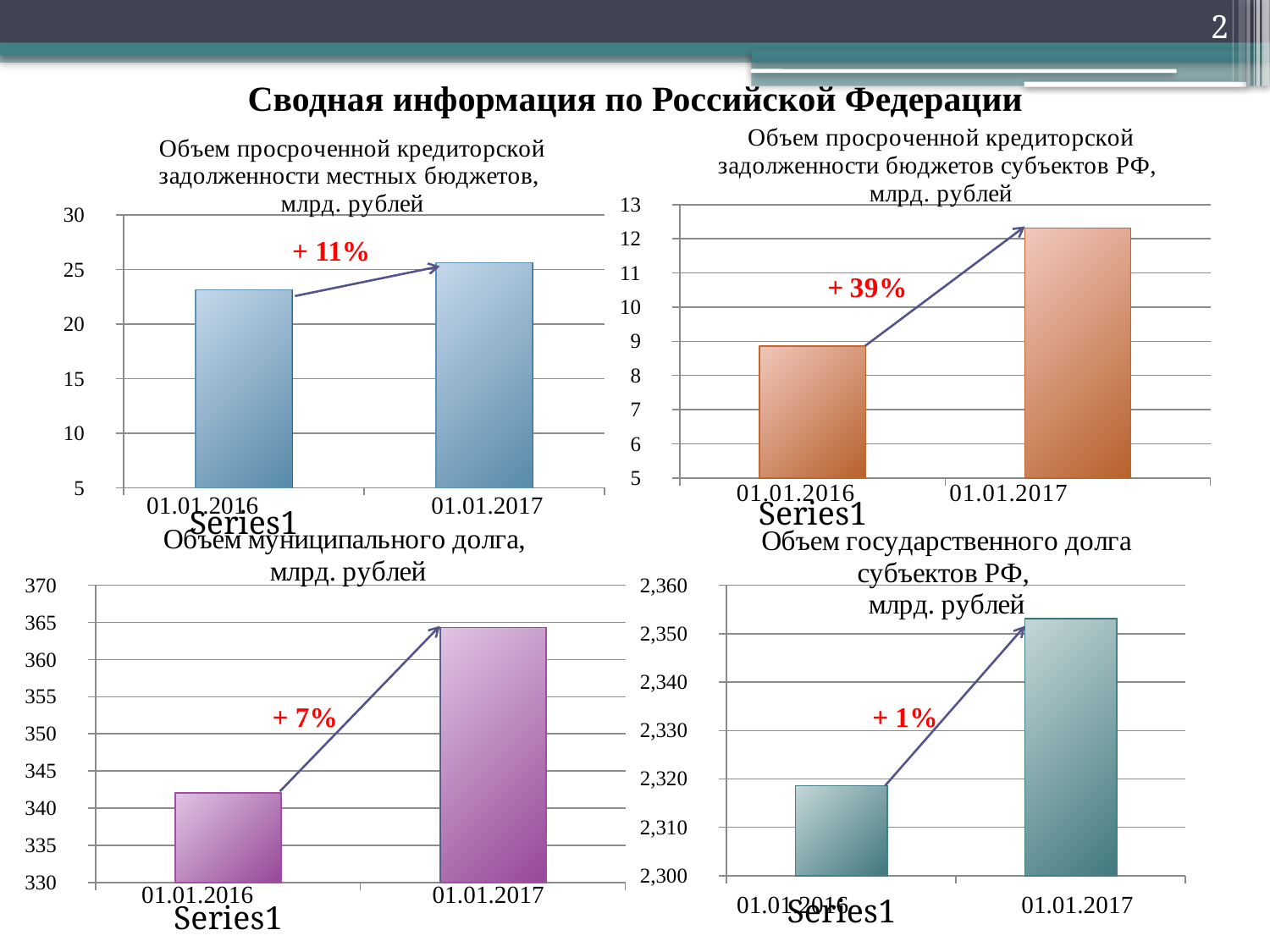
On the chart 'Объем государственного долга субъектов РФ', is the value for 01.01.2017 greater or less than 2,350? greater What percentage change is annotated on the chart 'Объем просроченной кредиторской задолженности бюджетов субъектов РФ'? + 39% On the chart 'Объем просроченной кредиторской задолженности местных бюджетов', is the value for 01.01.2016 greater or less than 20? greater On the chart 'Объем муниципального долга', is the value for 01.01.2016 greater or less than 345? less On the chart 'Объем государственного долга субъектов РФ', do the values rise or fall from 01.01.2016 to 01.01.2017? rise What percentage change is annotated on the chart 'Объем государственного долга субъектов РФ'? + 1% What kind of chart is 'Объем муниципального долга, млрд. рублей'? bar chart On the chart 'Объем муниципального долга', which date has the higher value, 01.01.2016 or 01.01.2017? 01.01.2017 How many bars are shown on the chart 'Объем просроченной кредиторской задолженности местных бюджетов'? 2